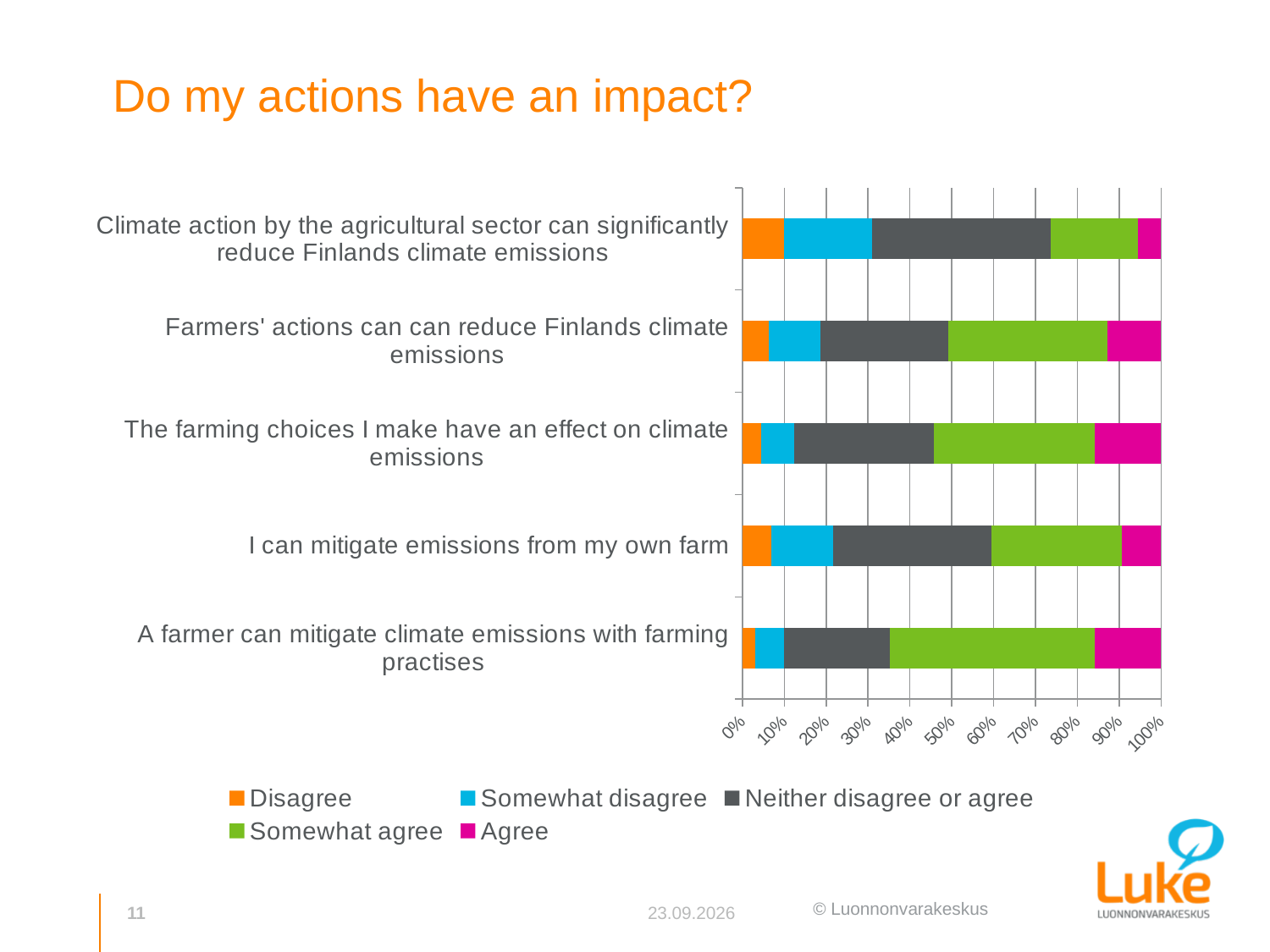
How many series does the legend list? 5 What is the title of the slide containing the chart? Do my actions have an impact? Which statement has the largest 'Neither disagree or agree' segment? Climate action by the agricultural sector can significantly reduce Finlands climate emissions How many statements (categories) are plotted in the chart? 5 What is the total of the stacked bar for 'I can mitigate emissions from my own farm'? 100% Which statement has the smallest 'Disagree' segment? A farmer can mitigate climate emissions with farming practises Which statement has the largest 'Somewhat agree' segment? A farmer can mitigate climate emissions with farming practises Is the 'Disagree' share for 'Climate action by the agricultural sector can significantly reduce Finlands climate emissions' greater or less than 20%? less Which colour represents the 'Agree' series in the chart? Magenta (pink) Is the 'Agree' segment larger for 'The farming choices I make have an effect on climate emissions' or for 'Climate action by the agricultural sector can significantly reduce Finlands climate emissions'? The farming choices I make have an effect on climate emissions Is the 'Somewhat agree' share for 'A farmer can mitigate climate emissions with farming practises' greater or less than 40%? greater What kind of chart is shown on the slide? Stacked bar chart